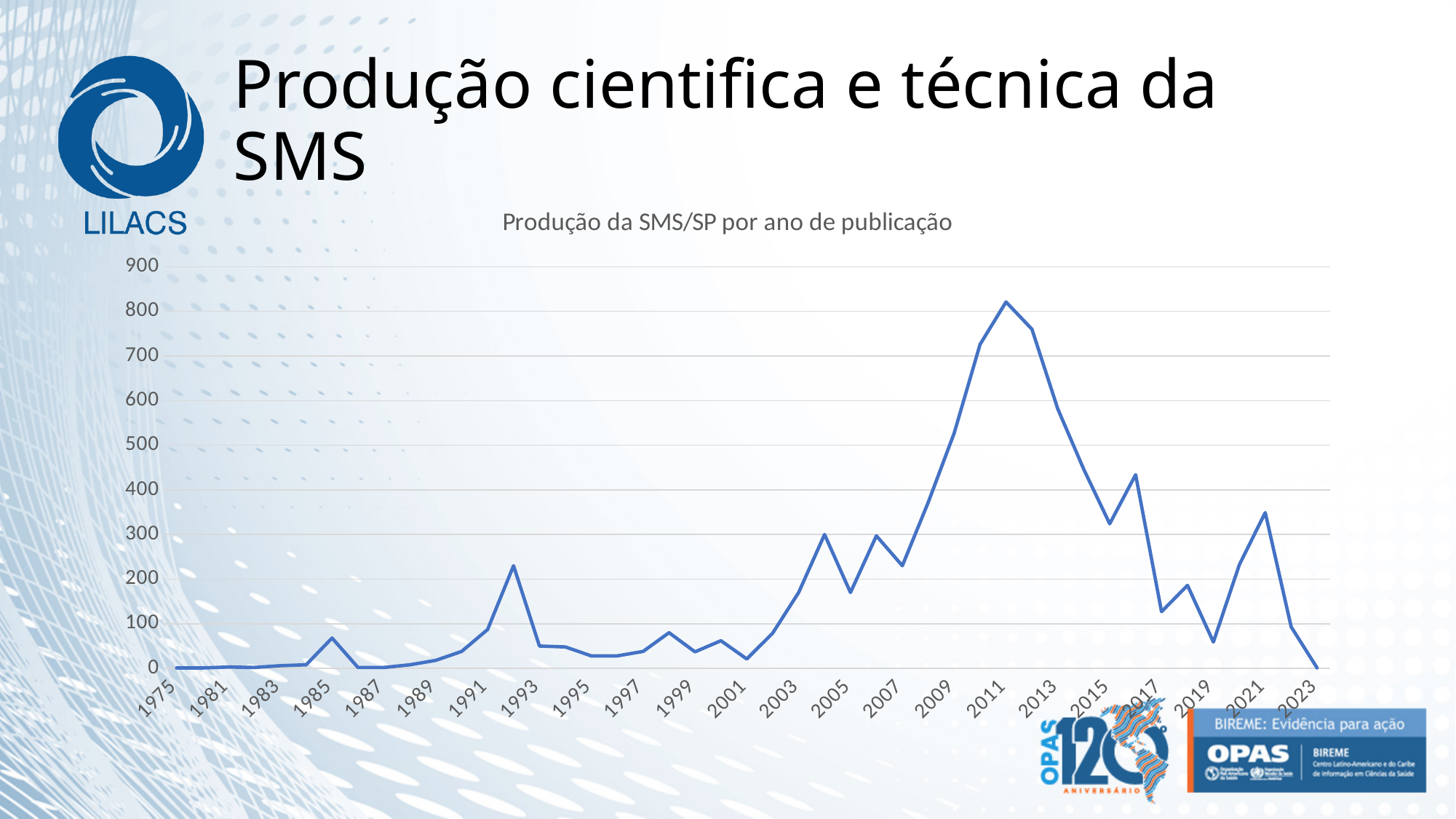
Do the values rise or fall from 2021 to 2023? fall Is the value for 2011 greater or less than 700? greater Is the value for 2007 greater or less than 200? greater Do the values rise or fall from 2007 to 2011? rise Is the value for 2023 greater or less than 100? less What is the title of the chart? Produção da SMS/SP por ano de publicação What kind of chart is shown on the slide? line chart